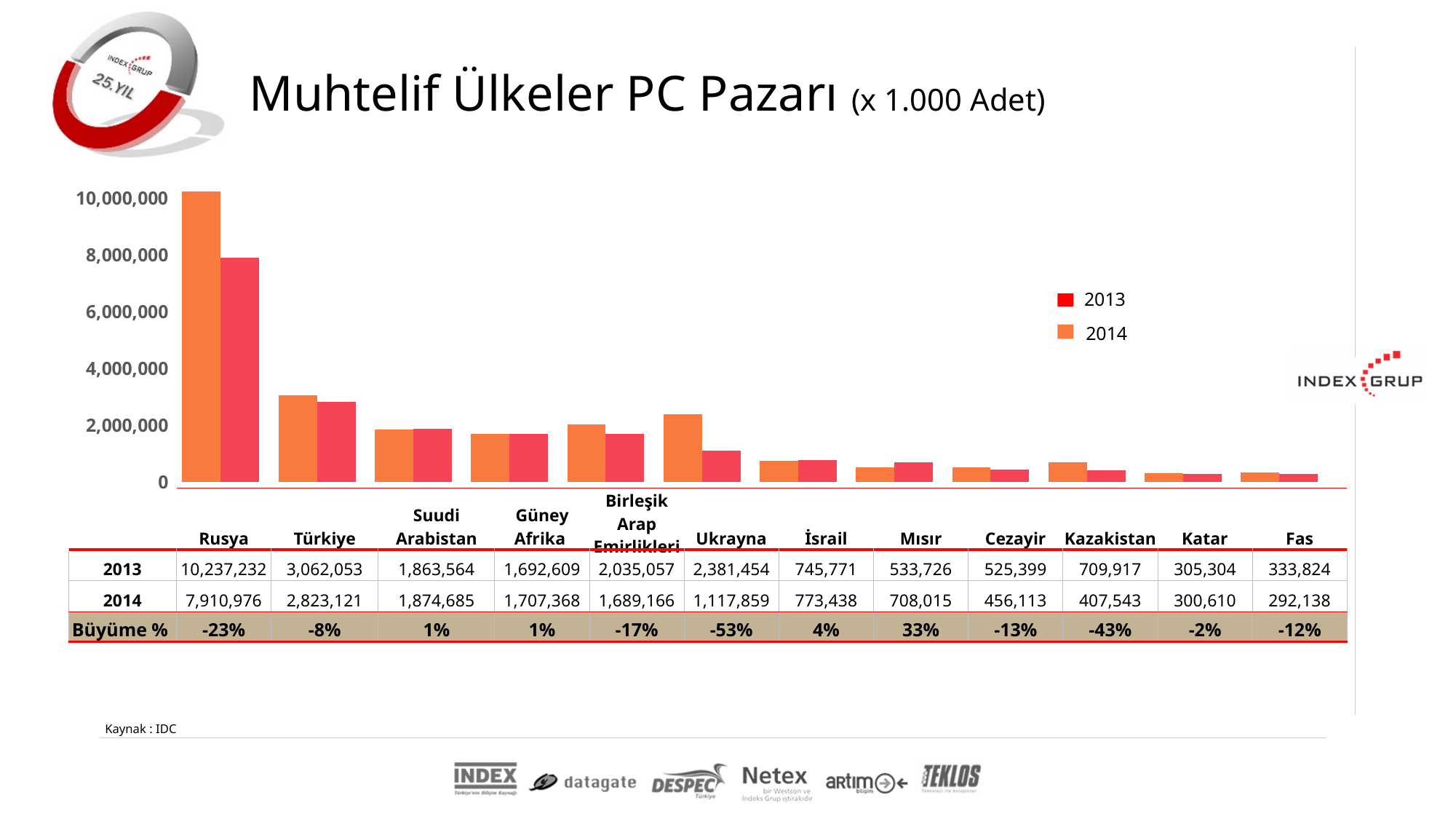
Which country has the highest 2013 value? Rusya What is the 2014 value for Ukrayna? 1,117,859 Which is larger, the 2014 value for İsrail or the 2014 value for Mısır? İsrail What is the Büyüme % value for Mısır? 33% Which country has the lowest 2014 value? Fas What is the difference between the 2013 and 2014 values for Rusya? 2,326,256 What is the source cited at the bottom of the slide? IDC What is the 2013 value for Rusya? 10,237,232 How many series does the legend list? 2 What type of chart is shown on the slide? bar chart What is the 2014 value for Türkiye? 2,823,121 How many countries are shown on the x axis of the chart? 12